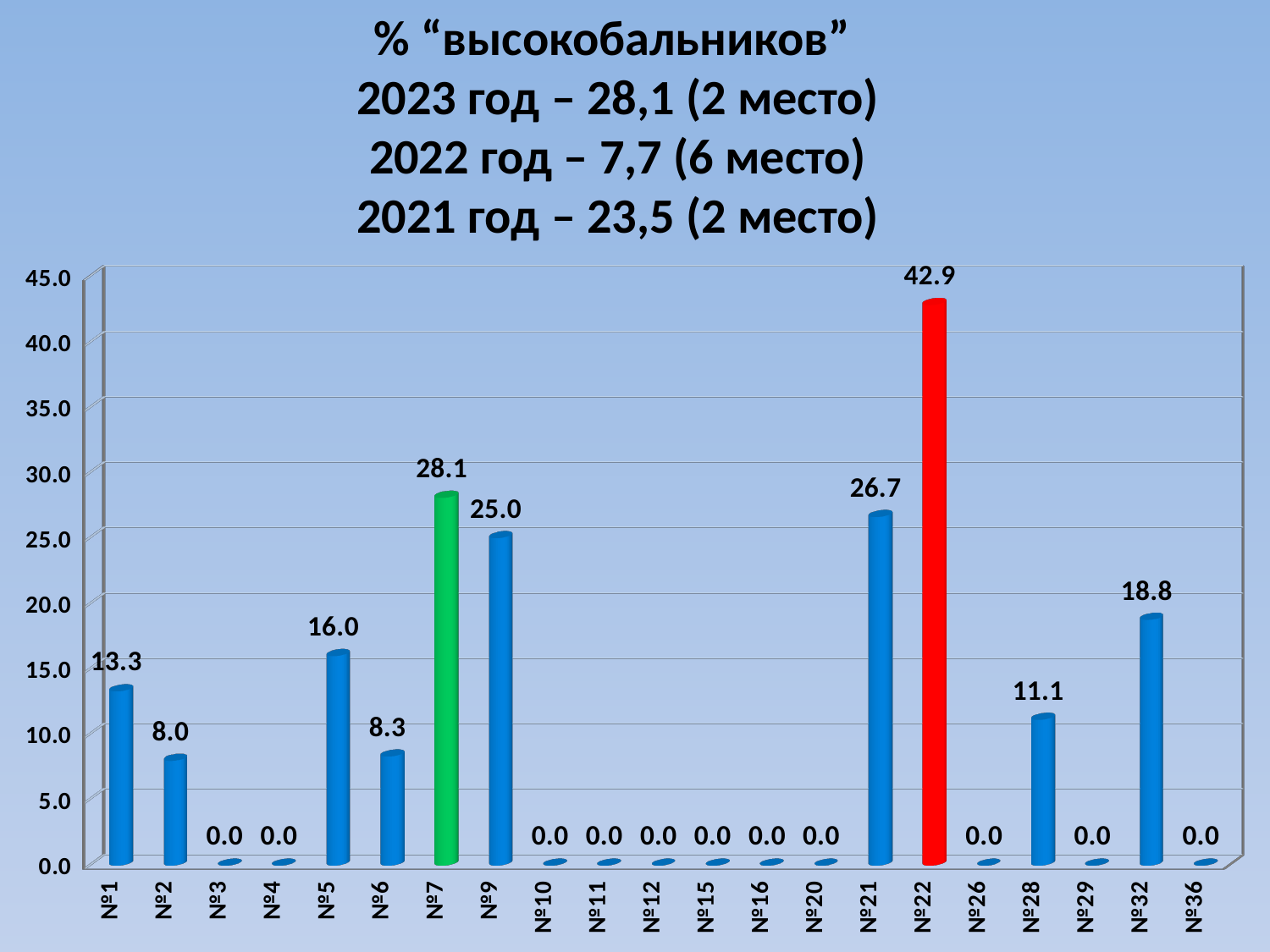
How many categories have a value of 0.0? 11 What is the difference between the values for №22 and №7? 14.8 What is the difference between the values for №21 and №9? 1.7 How many categories are shown on the x axis? 21 What is the value for №32? 18.8 What colour is the bar for №22? red Is the value for №21 greater or less than 25.0? greater Which is larger, the value for №5 or the value for №28? №5 Which category has the highest value? №22 What kind of chart is shown? bar chart What is the value for №7? 28.1 What is the value for №22? 42.9